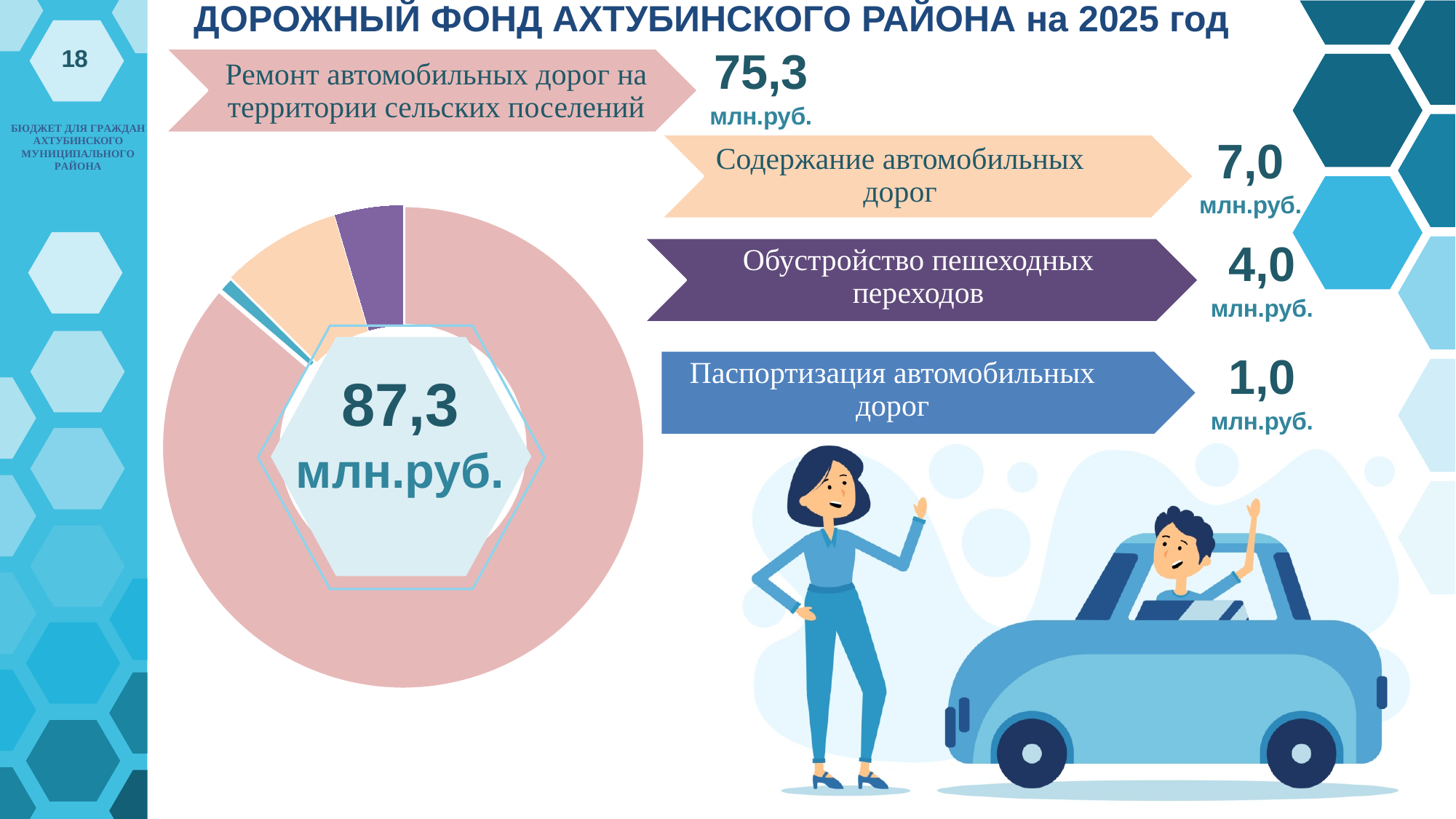
Which category has the smallest share of the pie chart? Паспортизация автомобильных дорог What is the value for «Обустройство пешеходных переходов»? 4,0 млн.руб. Which is larger: «Обустройство пешеходных переходов» or «Паспортизация автомобильных дорог»? Обустройство пешеходных переходов What is the value for «Ремонт автомобильных дорог на территории сельских поселений»? 75,3 млн.руб. What colour is the largest slice of the pie chart? pink What is the value for «Содержание автомобильных дорог»? 7,0 млн.руб. What is the value for «Паспортизация автомобильных дорог»? 1,0 млн.руб. What is the difference between «Содержание автомобильных дорог» and «Обустройство пешеходных переходов»? 3,0 млн.руб. Which category has the largest share of the pie chart? Ремонт автомобильных дорог на территории сельских поселений What is the total shown in the centre of the pie chart? 87,3 млн.руб. How many slices does the pie chart have? 4 What kind of chart is shown on the slide? doughnut chart